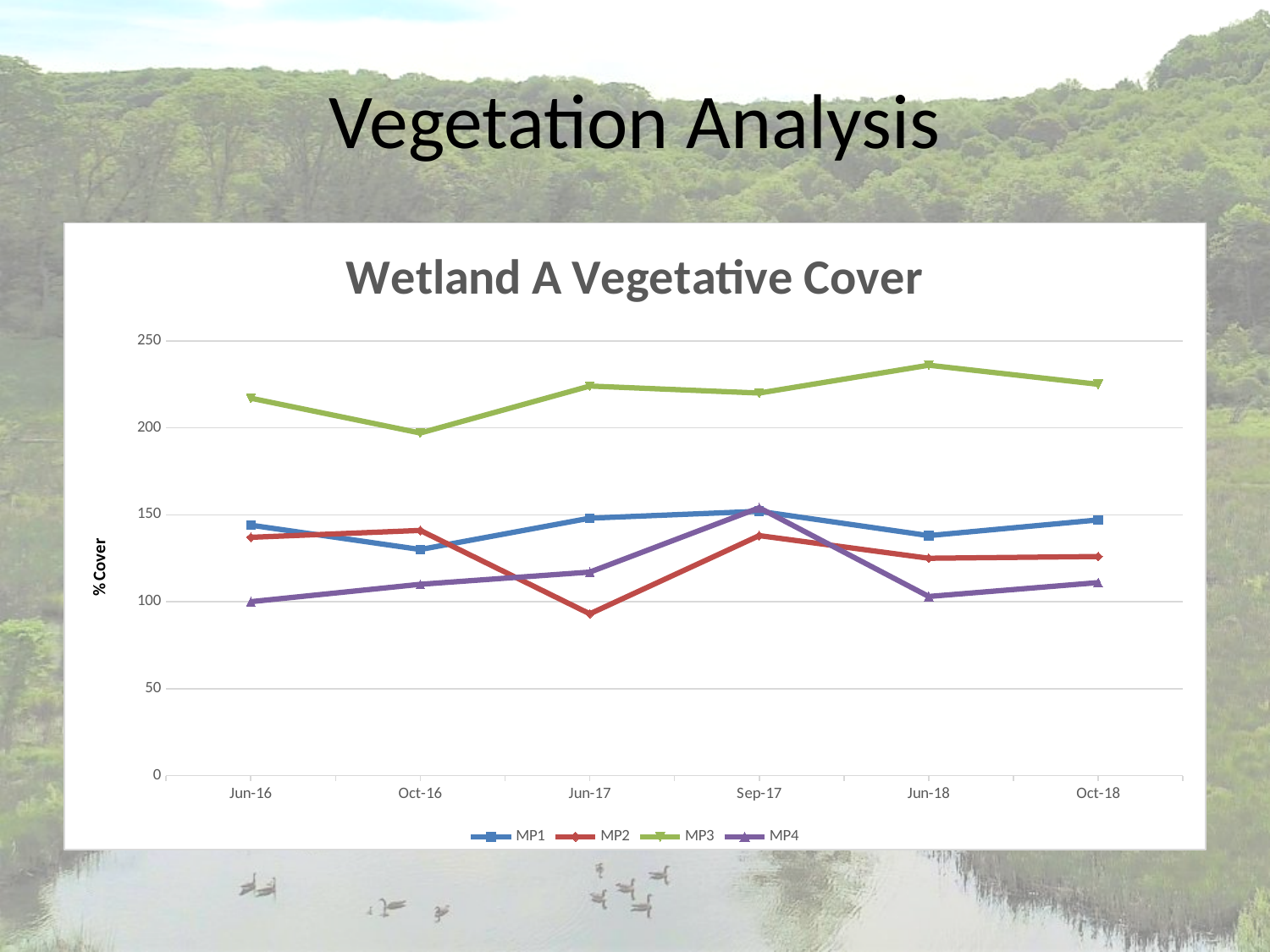
Which series has the highest values across the whole chart? MP3 How many time points are plotted along the x axis? 6 Is the value for MP3 at Jun-18 greater or less than 200? greater Is the value for MP1 at Oct-16 greater or less than 150? less What is the label on the vertical axis? % Cover How many series does the legend list? 4 Does MP3 rise or fall from Oct-16 to Jun-18? rise At which time point does MP3 reach its highest value? Jun-18 Is the value for MP2 at Jun-17 greater or less than 100? less What kind of chart is shown on the slide? line chart At Jun-16, which series has the larger value, MP1 or MP4? MP1 At which time point does MP2 reach its lowest value? Jun-17